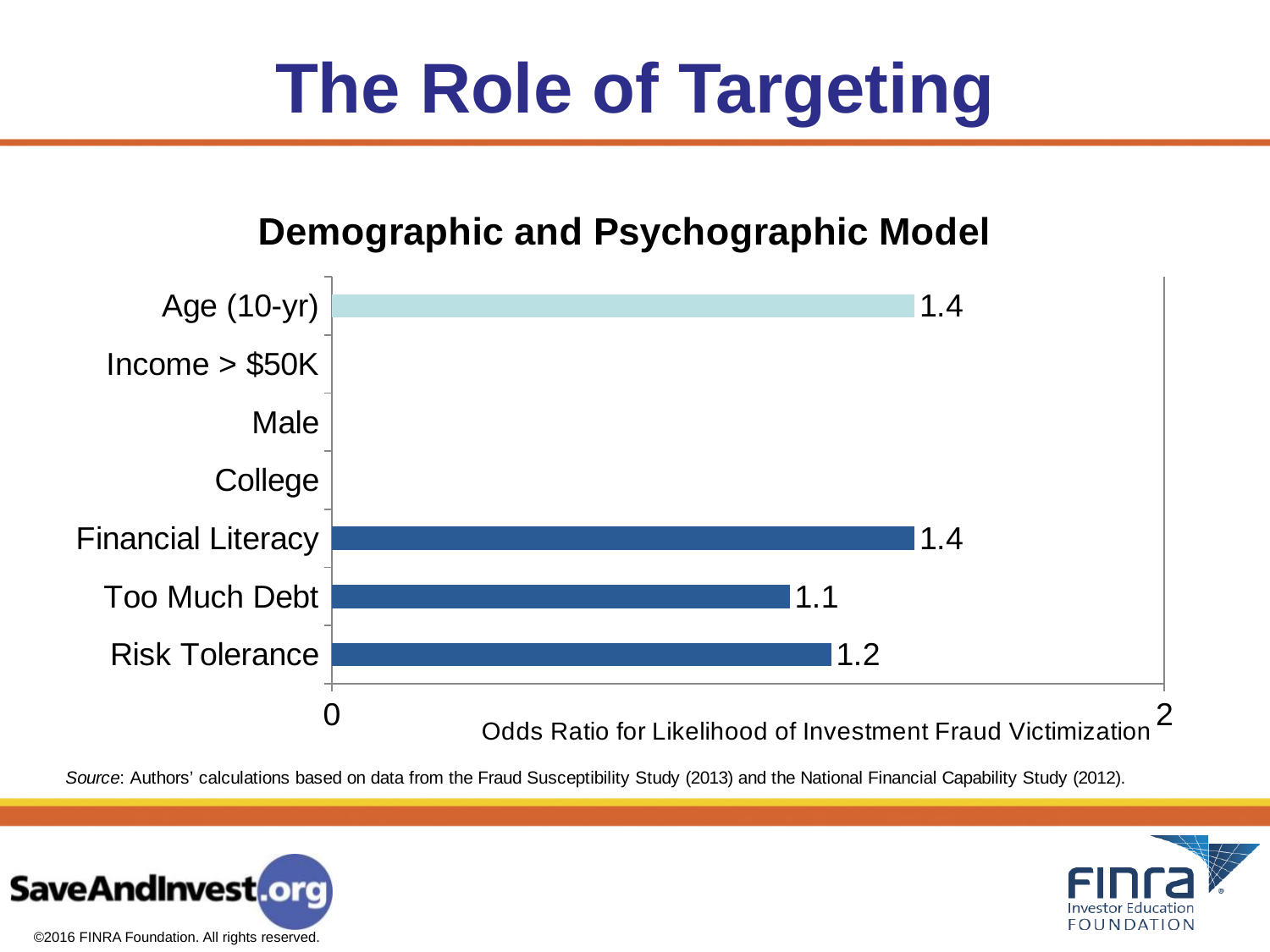
What is the difference between the odds ratios for Financial Literacy and Too Much Debt? 0.3 How many categories are listed on the vertical axis of the chart? 7 What is the odds ratio shown for Age (10-yr)? 1.4 What is the difference between the odds ratios for Risk Tolerance and Too Much Debt? 0.1 What is the odds ratio shown for Too Much Debt? 1.1 What kind of chart is shown on the slide? Bar chart What is the odds ratio shown for Financial Literacy? 1.4 Which has a larger odds ratio, Risk Tolerance or Too Much Debt? Risk Tolerance What is the odds ratio shown for Risk Tolerance? 1.2 What is the title of the chart? Demographic and Psychographic Model Is the value for Age (10-yr) greater or less than 2? less Among the categories with a plotted bar, which has the lowest odds ratio? Too Much Debt